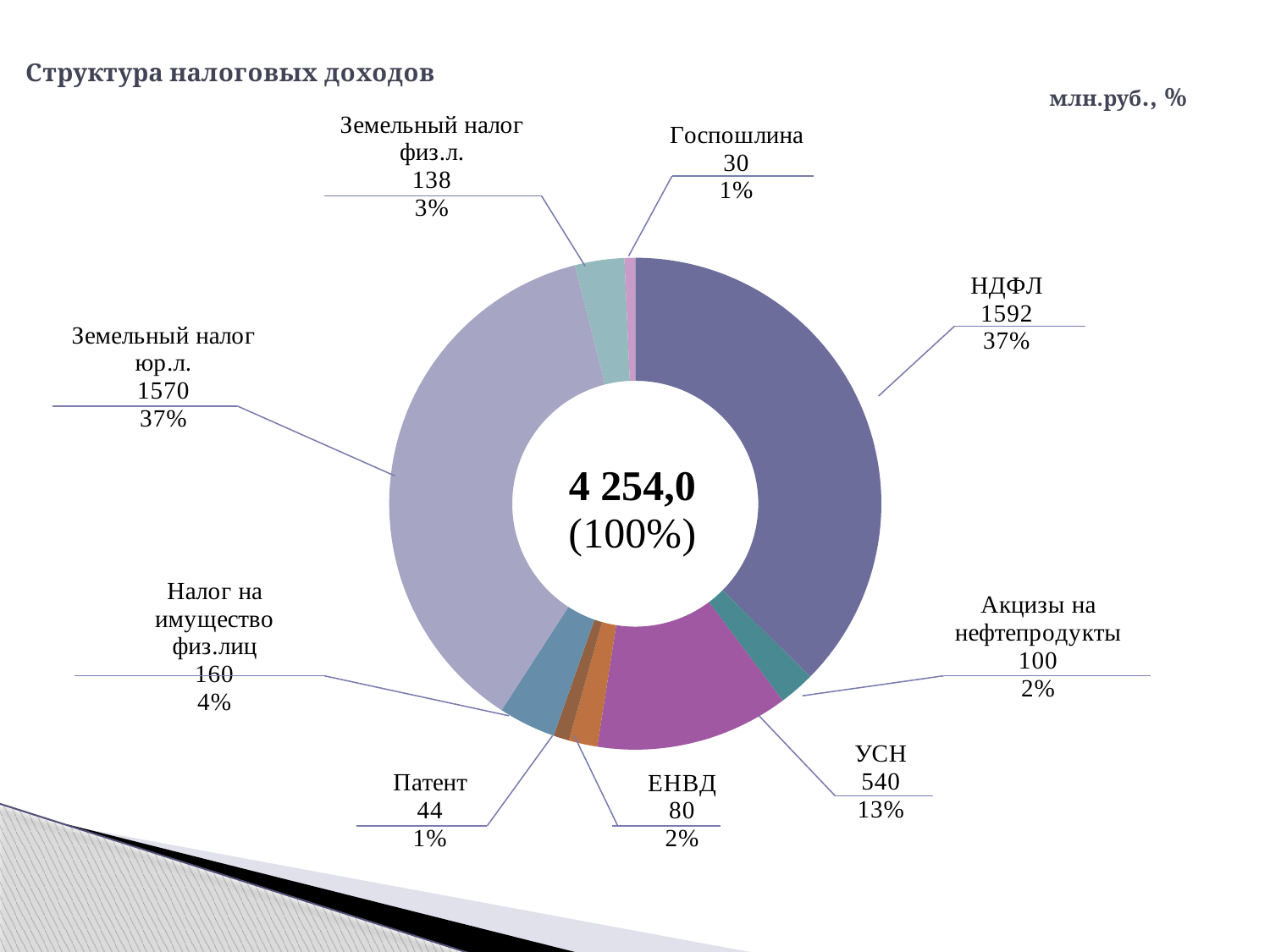
Which category has the largest value? НДФЛ What is the title of the chart? Структура налоговых доходов What is the value for НДФЛ? 1592 Which category has the smallest value? Госпошлина Which is larger, the value for Налог на имущество физ.лиц or the value for Земельный налог физ.л.? Налог на имущество физ.лиц What kind of chart is shown on the slide? Doughnut (pie) chart What is the difference between the values for УСН and ЕНВД? 460 What total is shown in the centre of the chart? 4 254,0 What is the value for Земельный налог юр.л.? 1570 What share of the total does УСН account for? 13% What share of the total does Акцизы на нефтепродукты account for? 2% How many categories are shown in the chart? 9